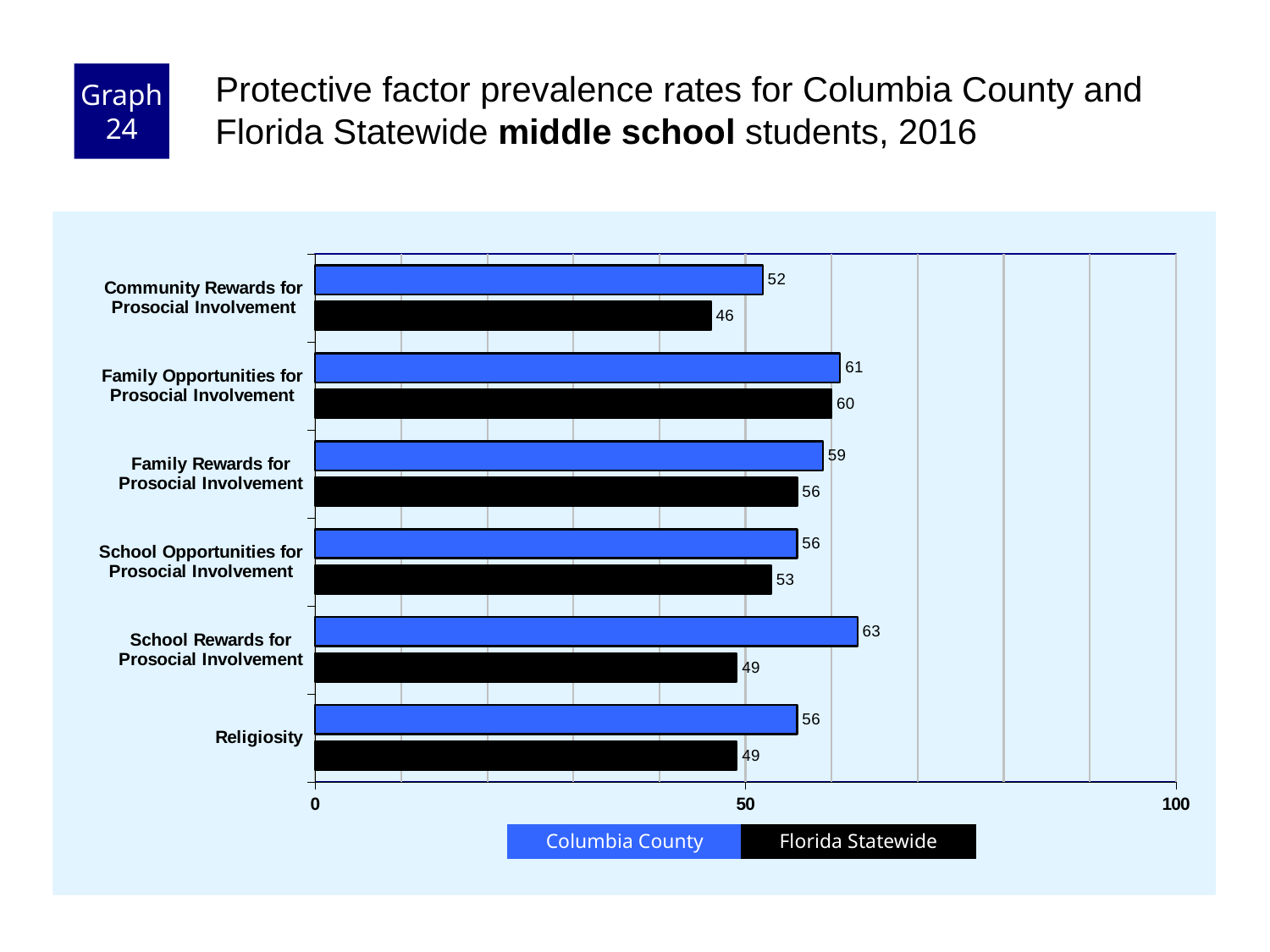
Which is larger for Family Rewards for Prosocial Involvement: the Columbia County value or the Florida Statewide value? Columbia County How many protective factor categories are shown on the chart? 6 Which colour represents Florida Statewide in the chart? Black Is the Florida Statewide value for School Opportunities for Prosocial Involvement greater or less than 50? greater What kind of chart is shown on the slide? Bar chart What is the Florida Statewide value for Religiosity? 49 Which category has the lowest Florida Statewide value? Community Rewards for Prosocial Involvement What is the Columbia County value for School Rewards for Prosocial Involvement? 63 How many series does the legend list? 2 Which category has the highest Columbia County value? School Rewards for Prosocial Involvement What is the Florida Statewide value for Community Rewards for Prosocial Involvement? 46 What is the difference between the Columbia County and Florida Statewide values for School Rewards for Prosocial Involvement? 14